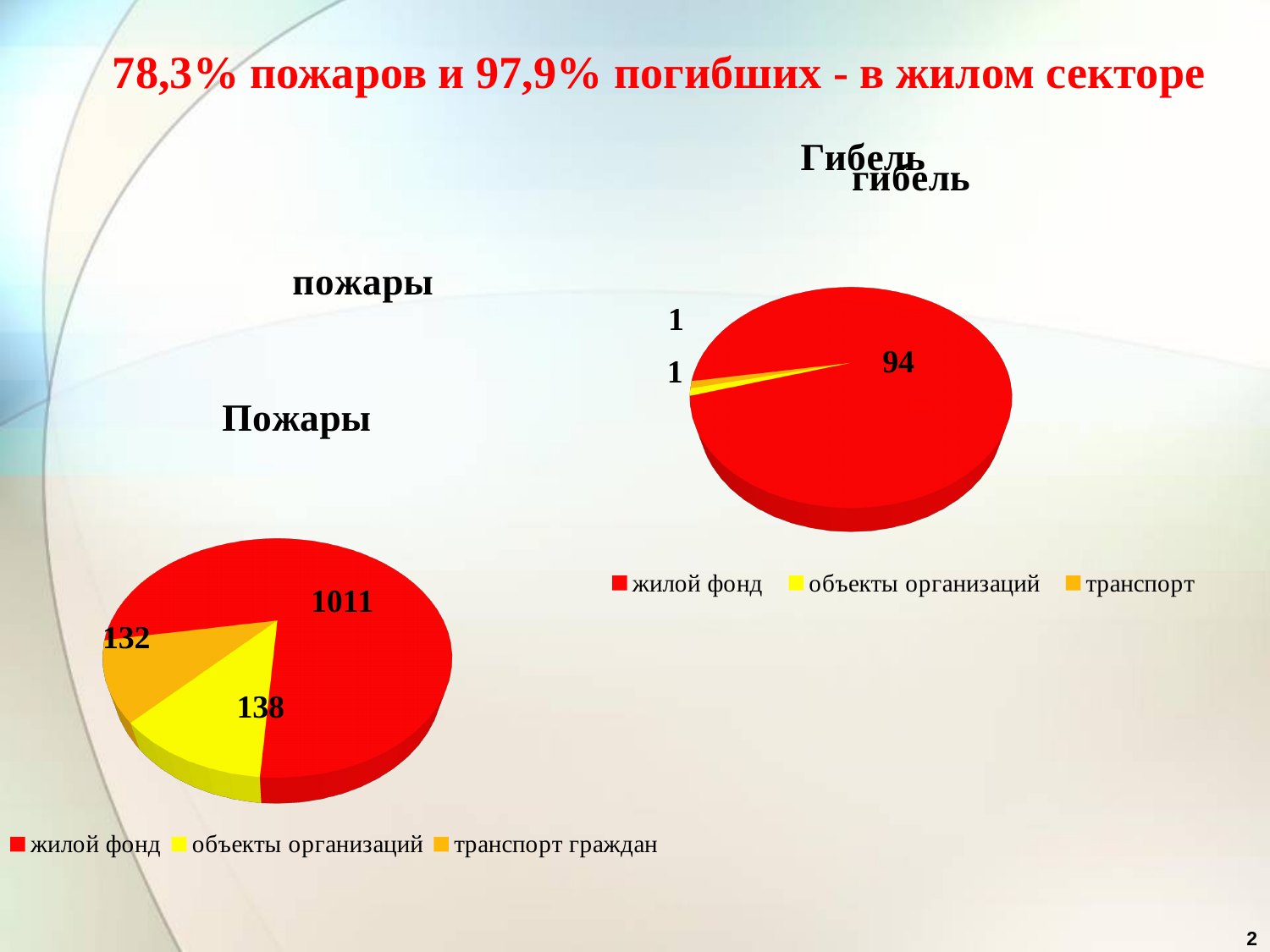
On the Гибель chart, what is the total of all slices? 96 What kind of chart is the Гибель chart? pie chart On the Пожары chart, which category has the largest slice? жилой фонд On the Пожары chart, which is larger: объекты организаций or транспорт граждан? объекты организаций How many pie charts are on the slide? 2 How many categories does the legend of the Гибель chart list? 3 On the Пожары chart, what is the value for транспорт граждан? 132 On the Гибель chart, what is the value for жилой фонд? 94 On the Пожары chart, what is the value for жилой фонд? 1011 On the Пожары chart, what is the difference between the values for объекты организаций and транспорт граждан? 6 On the Пожары chart, what is the value for объекты организаций? 138 On the Пожары chart, which category has the smallest slice? транспорт граждан